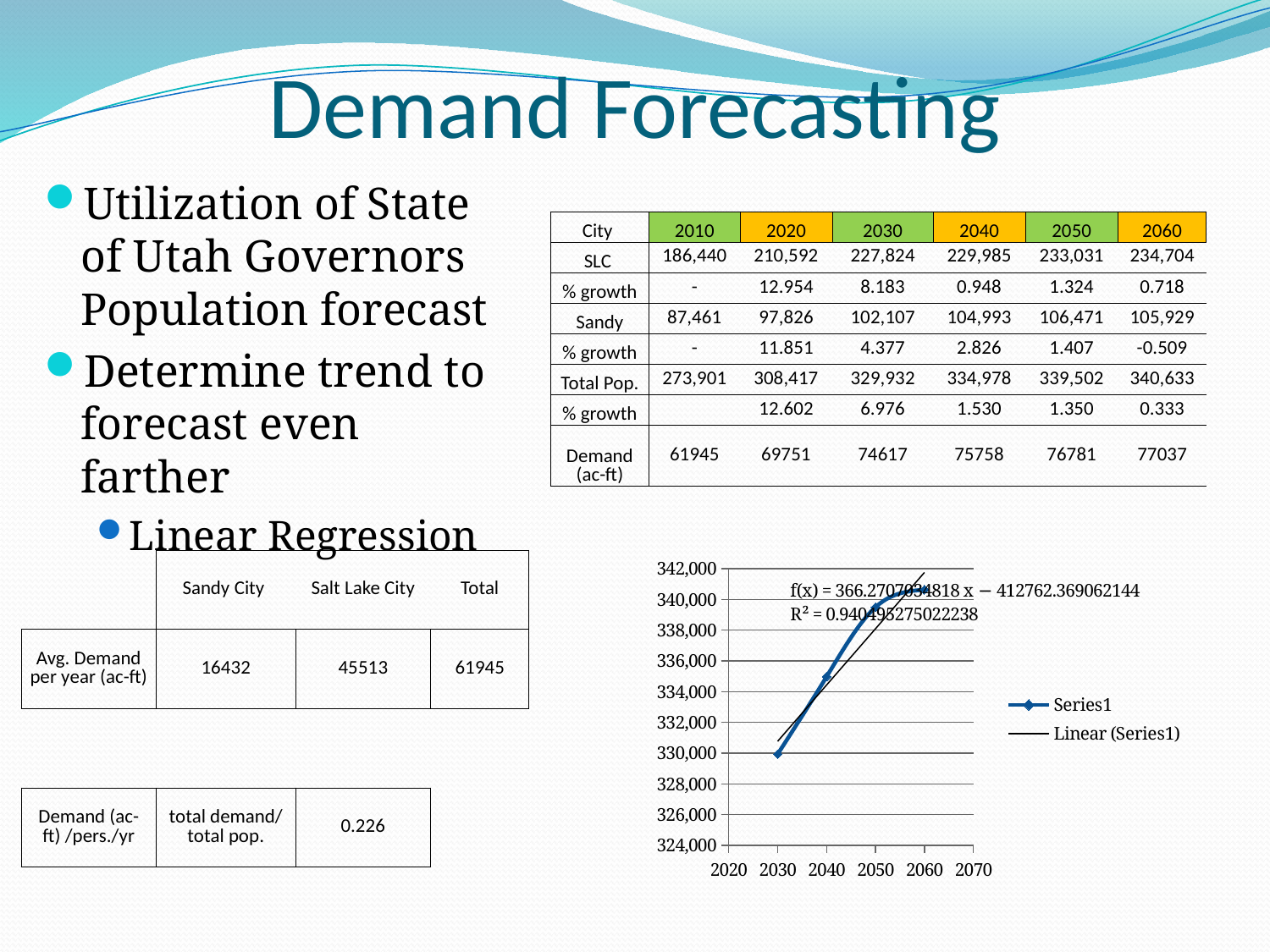
Which year has the lowest Series1 value on the chart? 2030 How many entries does the chart's legend list? 2 Is the Series1 value at 2050 greater or less than 338,000? greater What is the lowest value shown on the chart's y axis? 324,000 Do the Series1 values rise or fall as the years increase along the x axis? rise What kind of chart is shown on the slide? line chart What are the two entries in the chart's legend? Series1 and Linear (Series1) Which is larger, the Series1 value at 2030 or at 2050? 2050 Is the Series1 value at 2040 greater or less than 336,000? less Is the Series1 value at 2040 greater or less than 334,000? greater